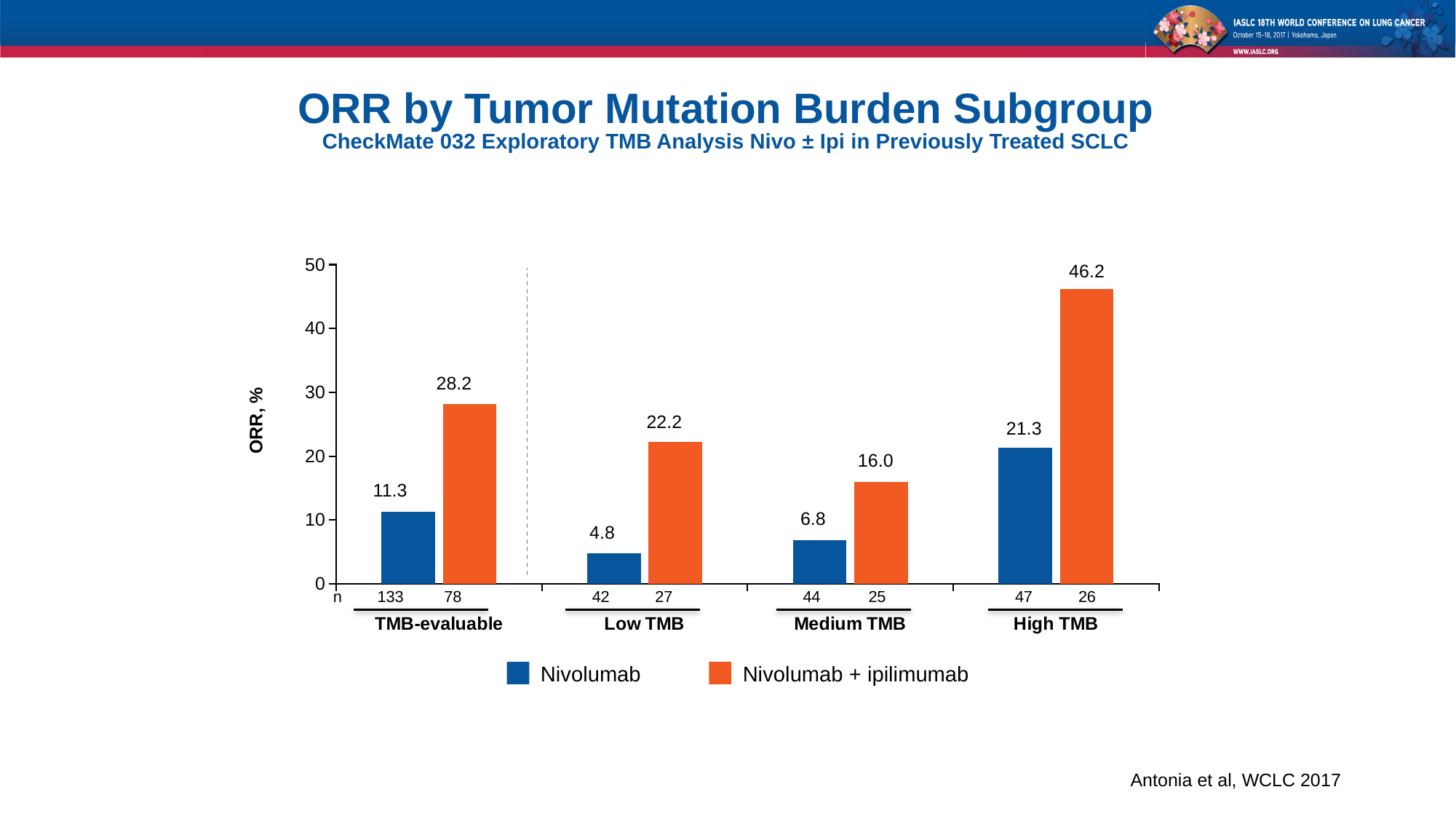
How many series does the legend list? 2 What is the difference in ORR between Nivolumab + ipilimumab and Nivolumab in the Medium TMB subgroup? 9.2 Which is larger: the ORR for Nivolumab in the High TMB subgroup or the ORR for Nivolumab + ipilimumab in the Medium TMB subgroup? Nivolumab in the High TMB subgroup What is the ORR for Nivolumab in the TMB-evaluable group? 11.3 What is the difference in ORR between Nivolumab + ipilimumab and Nivolumab in the High TMB subgroup? 24.9 What is the label of the y axis? ORR, % Which subgroup has the lowest ORR for Nivolumab? Low TMB Which subgroup has the highest ORR for Nivolumab + ipilimumab? High TMB What is the ORR for Nivolumab + ipilimumab in the Low TMB subgroup? 22.2 What kind of chart is shown on the slide? Bar chart What is the ORR for Nivolumab in the High TMB subgroup? 21.3 How many subgroups are shown on the x axis? 4